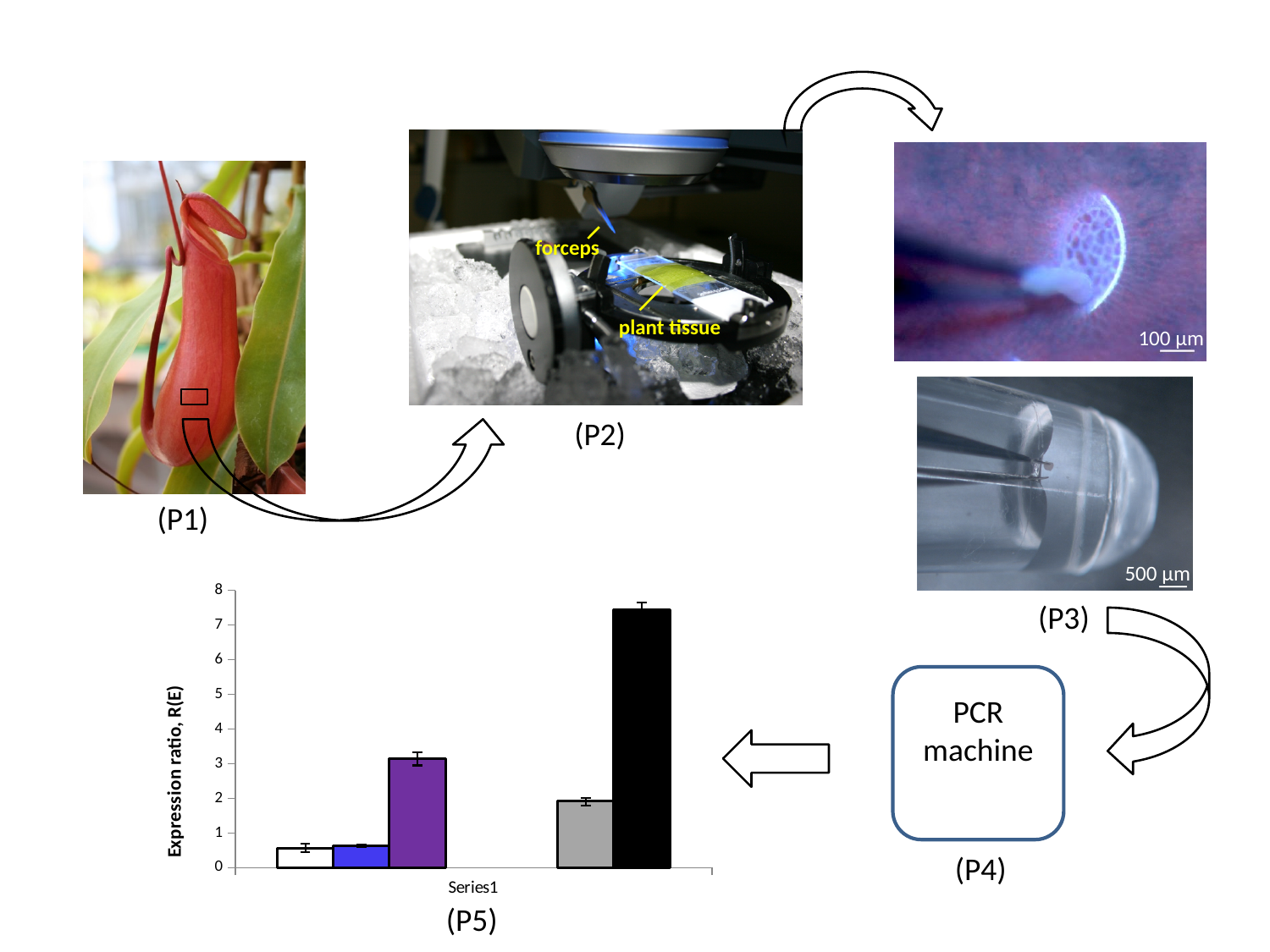
In the chart at (P5), which is larger, the purple bar or the grey bar? the purple bar In the chart at (P5), is the value of the white bar greater or less than 1? less How many bars are plotted in the chart at (P5)? 5 What kind of chart is shown at (P5)? bar chart What is the maximum value shown on the y-axis of the chart at (P5)? 8 In the chart at (P5), is the value of the grey bar greater or less than 1? greater In the chart at (P5), is the value of the black bar greater or less than 7? greater What is the y-axis title of the chart at (P5)? Expression ratio, R(E) Which bar in the chart at (P5) has the highest value? the black bar In the chart at (P5), which is larger, the black bar or the purple bar? the black bar